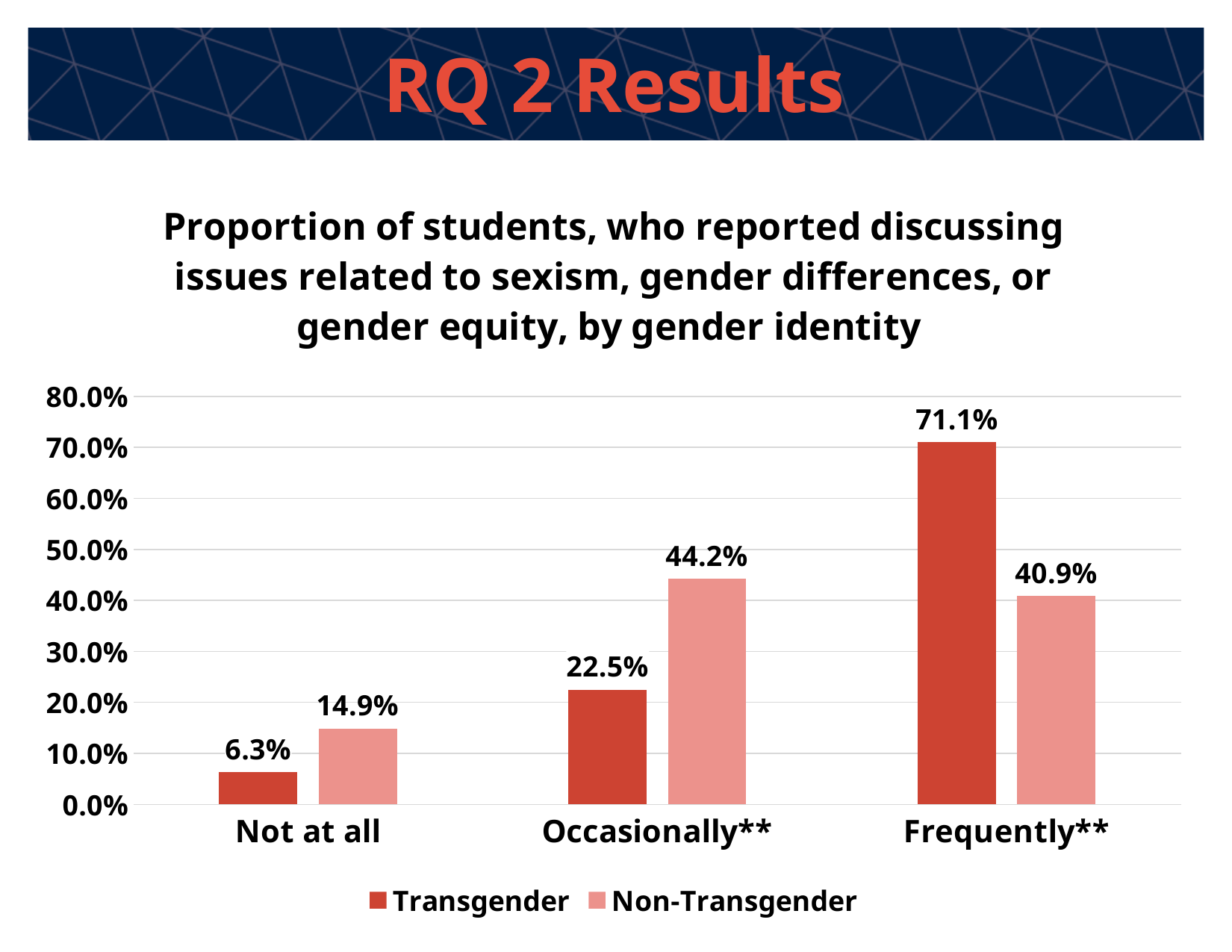
What is the difference between the Transgender and Non-Transgender values in the Frequently** category? 30.2% Is the value for Non-Transgender students in the Frequently** category greater or less than 50.0%? less What is the value for Transgender students in the Occasionally** category? 22.5% Which category has the highest value for the Non-Transgender series? Occasionally** Which is larger in the Occasionally** category: the Transgender value or the Non-Transgender value? Non-Transgender How many categories are shown on the x axis? 3 Which series is shown in the darker red colour? Transgender What kind of chart is shown on the slide? bar chart Which category has the lowest value for the Transgender series? Not at all How many series does the legend list? 2 What is the value for Non-Transgender students in the Not at all category? 14.9% What is the value for Transgender students in the Frequently** category? 71.1%